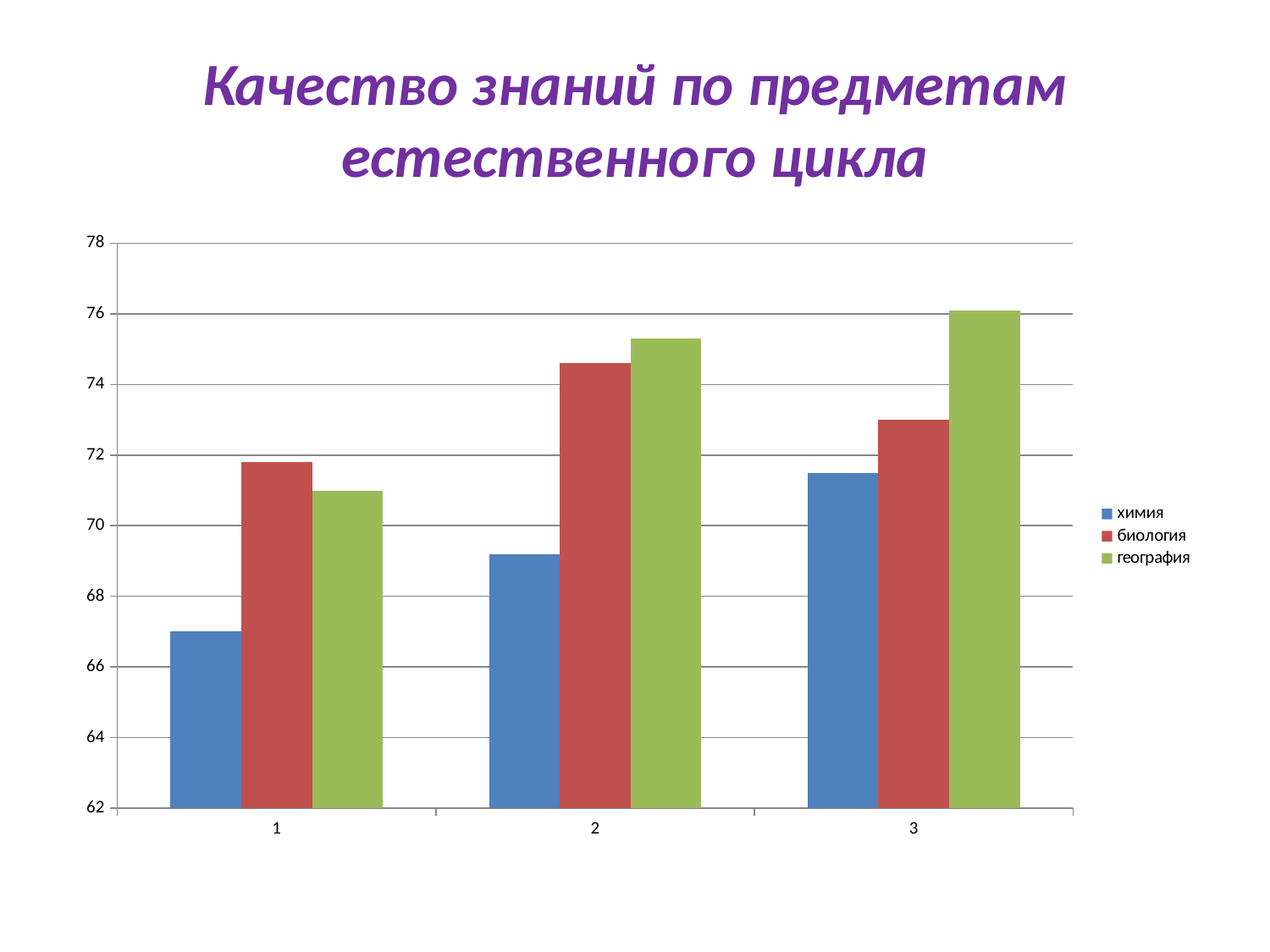
What kind of chart is shown on the slide? bar chart What colour are the bars for география? green Is the value for химия in category 1 greater or less than 68? less In category 3, which is larger: биология or география? география Is the value for химия in category 3 greater or less than 70? greater Which series has the lowest bar in category 1? химия Is the value for география in category 3 greater or less than 74? greater How many categories are shown on the x axis? 3 Do the values for химия rise or fall from category 1 to category 3? rise Which series has the highest bar in category 3? география How many series does the legend list? 3